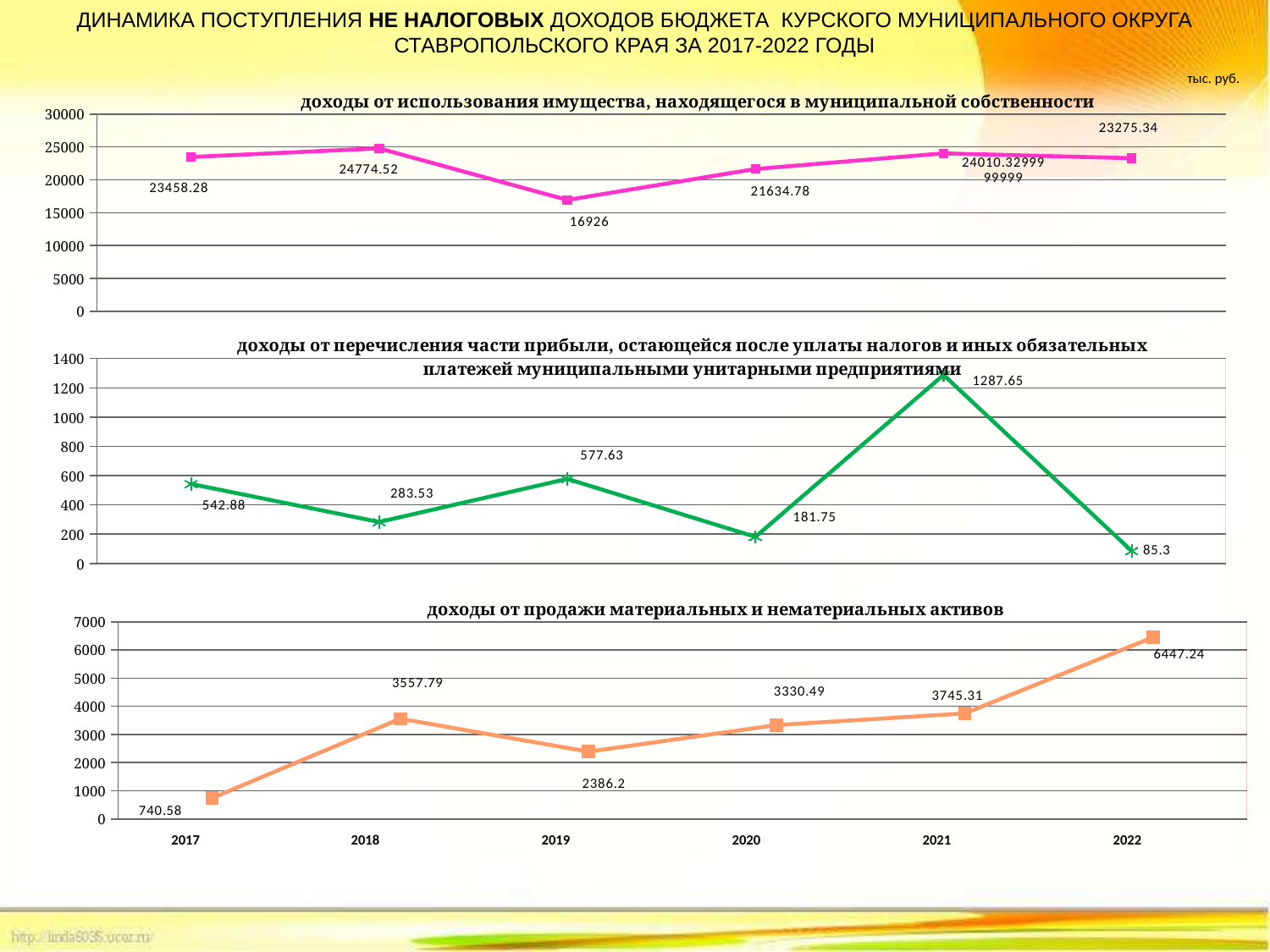
In the bottom chart (доходы от продажи материальных и нематериальных активов), what is the value for 2022? 6447.24 In the middle chart (доходы от перечисления части прибыли), which year has the lowest value? 2022 In the bottom chart (доходы от продажи материальных и нематериальных активов), which is larger, the value for 2018 or the value for 2020? 2018 In the top chart (доходы от использования имущества), what is the value for 2019? 16926 In the middle chart (доходы от перечисления части прибыли), which year has the highest value? 2021 In the top chart (доходы от использования имущества), what is the difference between the 2018 value and the 2017 value? 1316.24 What kind of chart is the top chart, 'доходы от использования имущества, находящегося в муниципальной собственности'? line chart How many data points are plotted in the bottom chart (доходы от продажи материальных и нематериальных активов)? 6 In the middle chart (доходы от перечисления части прибыли), what is the value for 2020? 181.75 In the top chart (доходы от использования имущества), which year has the lowest value? 2019 In the top chart (доходы от использования имущества), is the value for 2017 greater or less than 20000? greater In the middle chart (доходы от перечисления части прибыли), what is the value for 2021? 1287.65